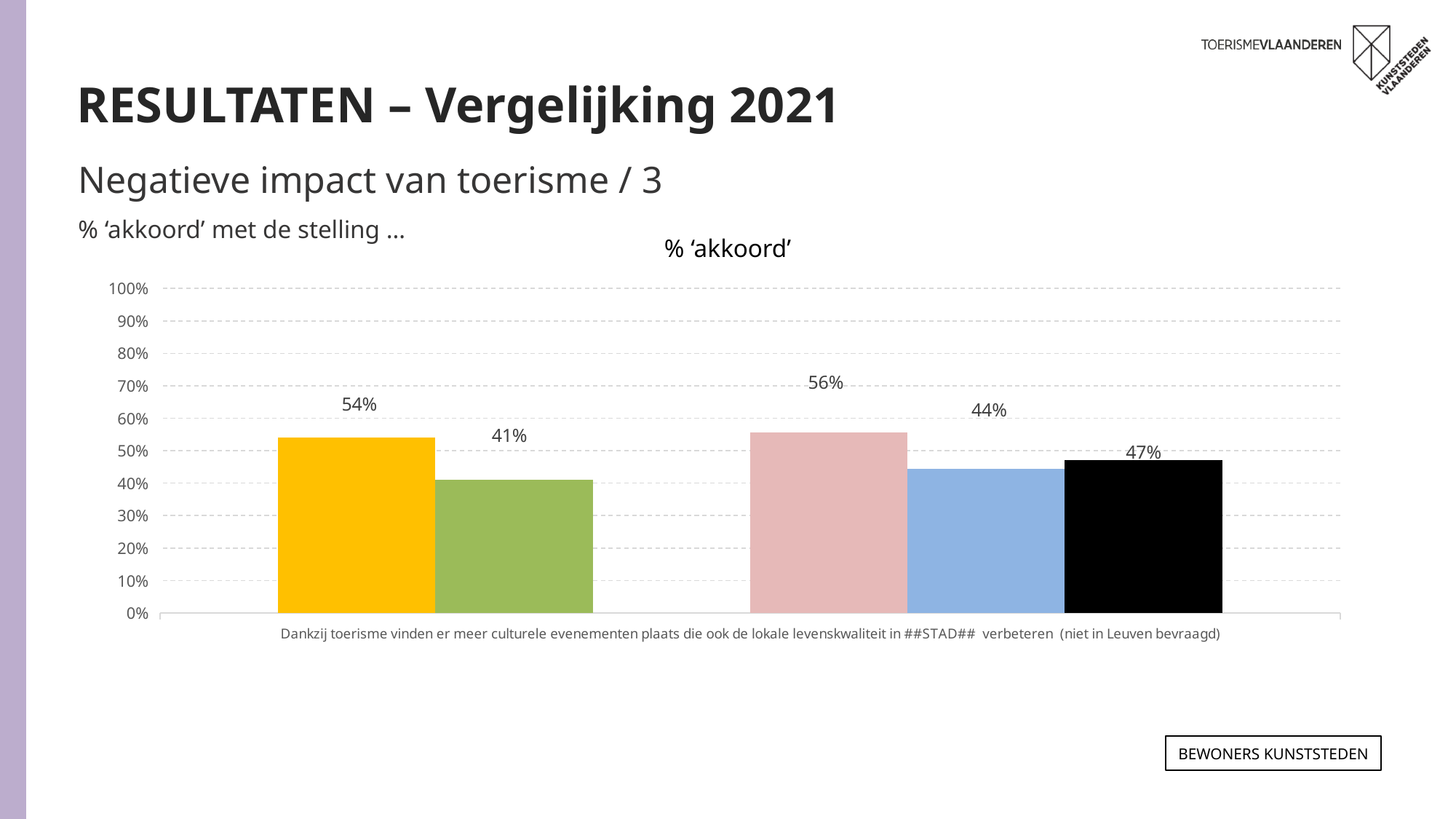
How many bars are plotted in the chart? 5 Which bar has the lowest value? The green bar (41%) What is the value shown on the black bar? 47% What kind of chart is shown on the slide? Bar chart What is the value shown on the green bar? 41% What is the value shown on the pink bar? 56% What is the value shown on the blue bar? 44% What is the value shown on the yellow bar? 54% Which is larger, the black bar or the blue bar? The black bar Which bar has the highest value? The pink bar (56%) What is the title of the chart? % ‘akkoord’ What is the difference between the yellow bar and the green bar? 13 percentage points